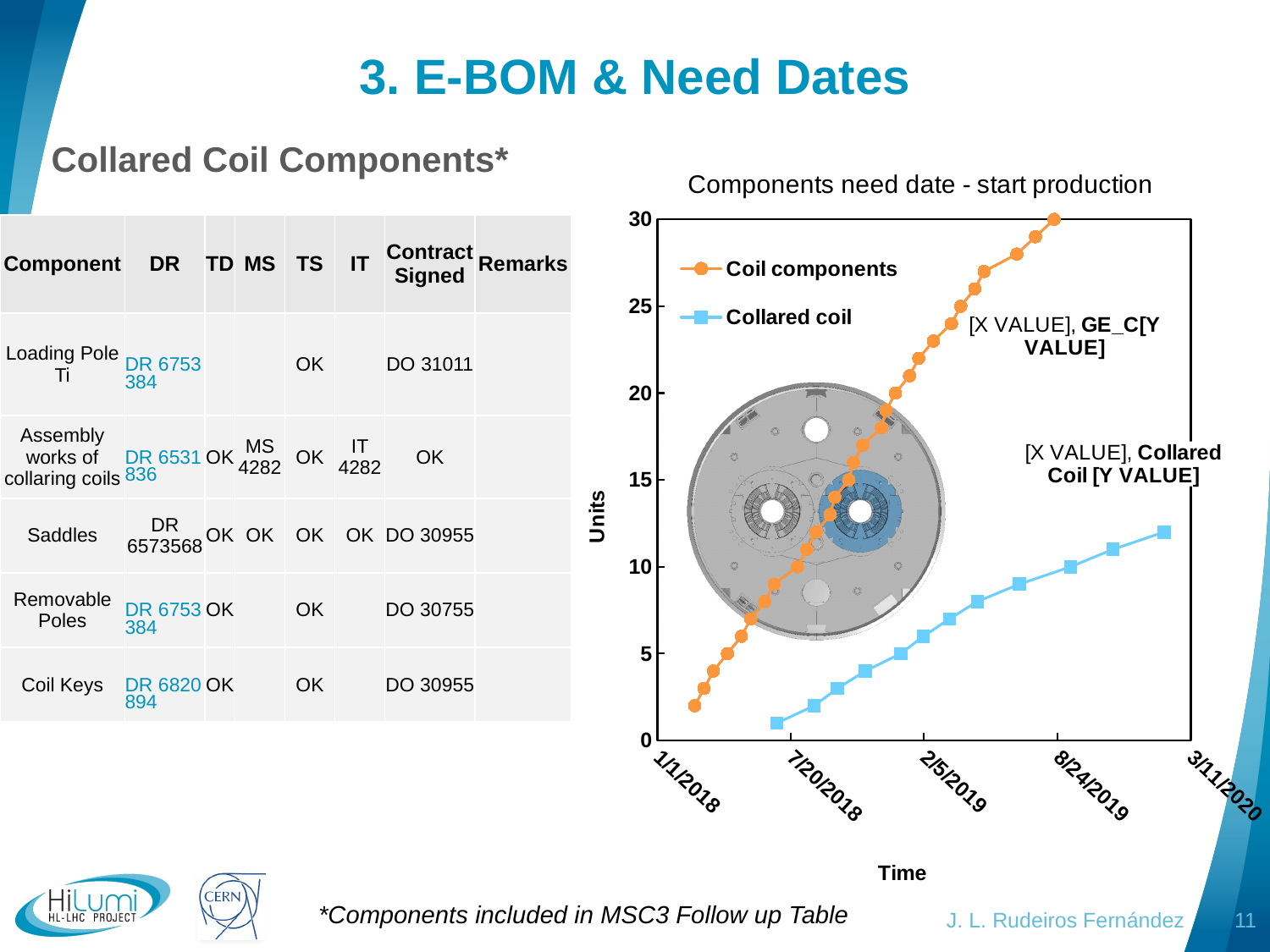
Which series reaches the higher value at the end of the chart, Coil components or Collared coil? Coil components Is the first value of the Coil components series greater or less than 5? less Do the values of the Collared coil series rise or fall over time? rise Do the values of the Coil components series rise or fall over time? rise Which series has the lower values throughout the chart? Collared coil How many data points are plotted for the Collared coil series? 12 How many series does the chart legend list? 2 Is the final value of the Collared coil series greater or less than 15? less What is the title of the chart? Components need date - start production What is the label of the vertical axis of the chart? Units Is the final value of the Coil components series greater or less than 25? greater What type of chart is shown on the slide? line chart